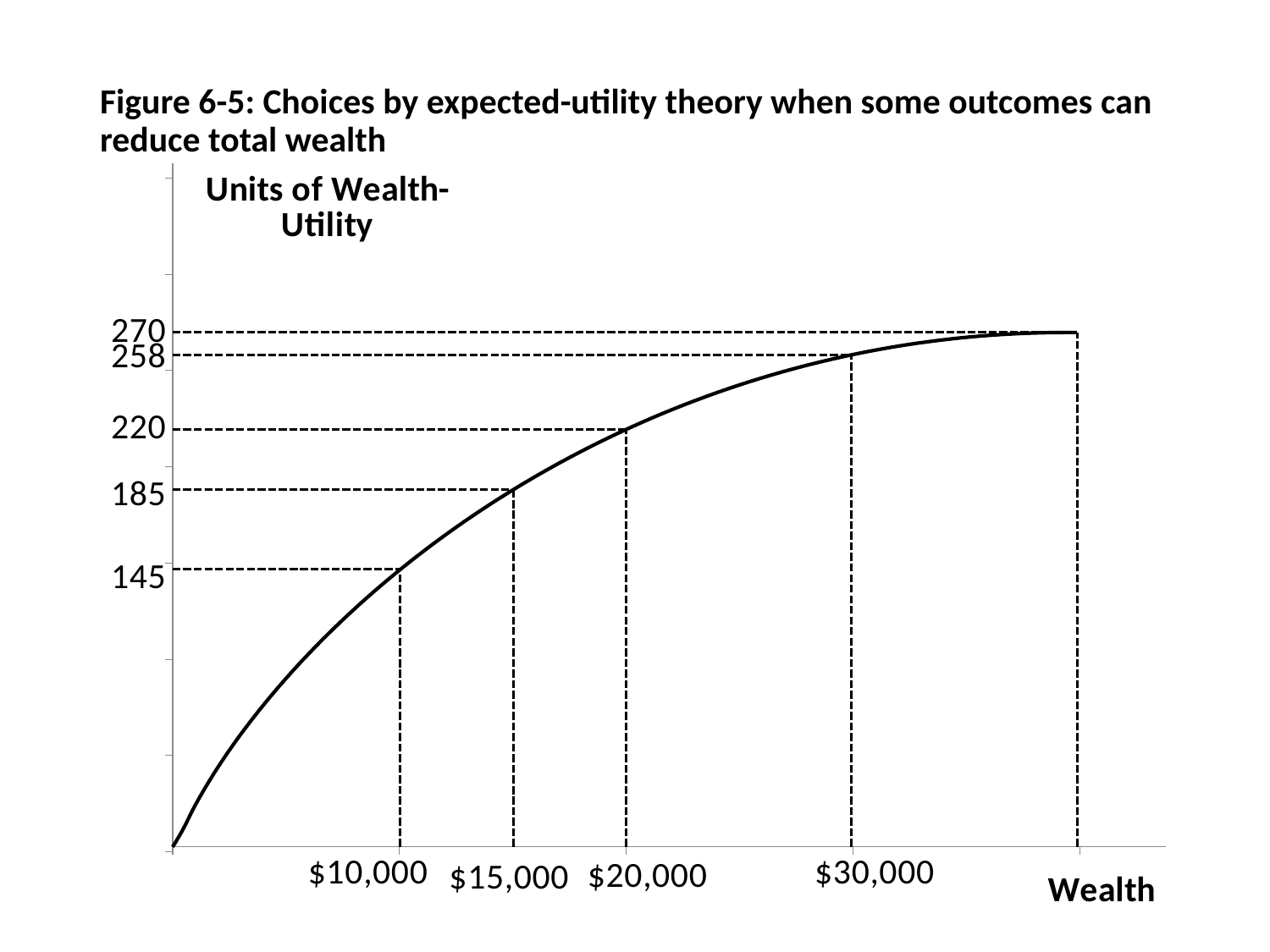
Which wealth level gives higher utility, $15,000 or $30,000? $30,000 What is the difference in utility between a wealth of $20,000 and a wealth of $10,000? 75 What is the utility value at a wealth of $20,000? 220 What is the difference in utility between a wealth of $30,000 and a wealth of $20,000? 38 What is the utility value at a wealth of $15,000? 185 What is the highest utility value marked on the vertical axis? 270 What is the label of the vertical axis? Units of Wealth-Utility How many wealth levels are labelled on the horizontal axis? 4 Does utility rise or fall as wealth increases along the horizontal axis? rise What is the utility value at a wealth of $10,000? 145 What is the lowest utility value marked on the vertical axis? 145 What is the utility value at a wealth of $30,000? 258